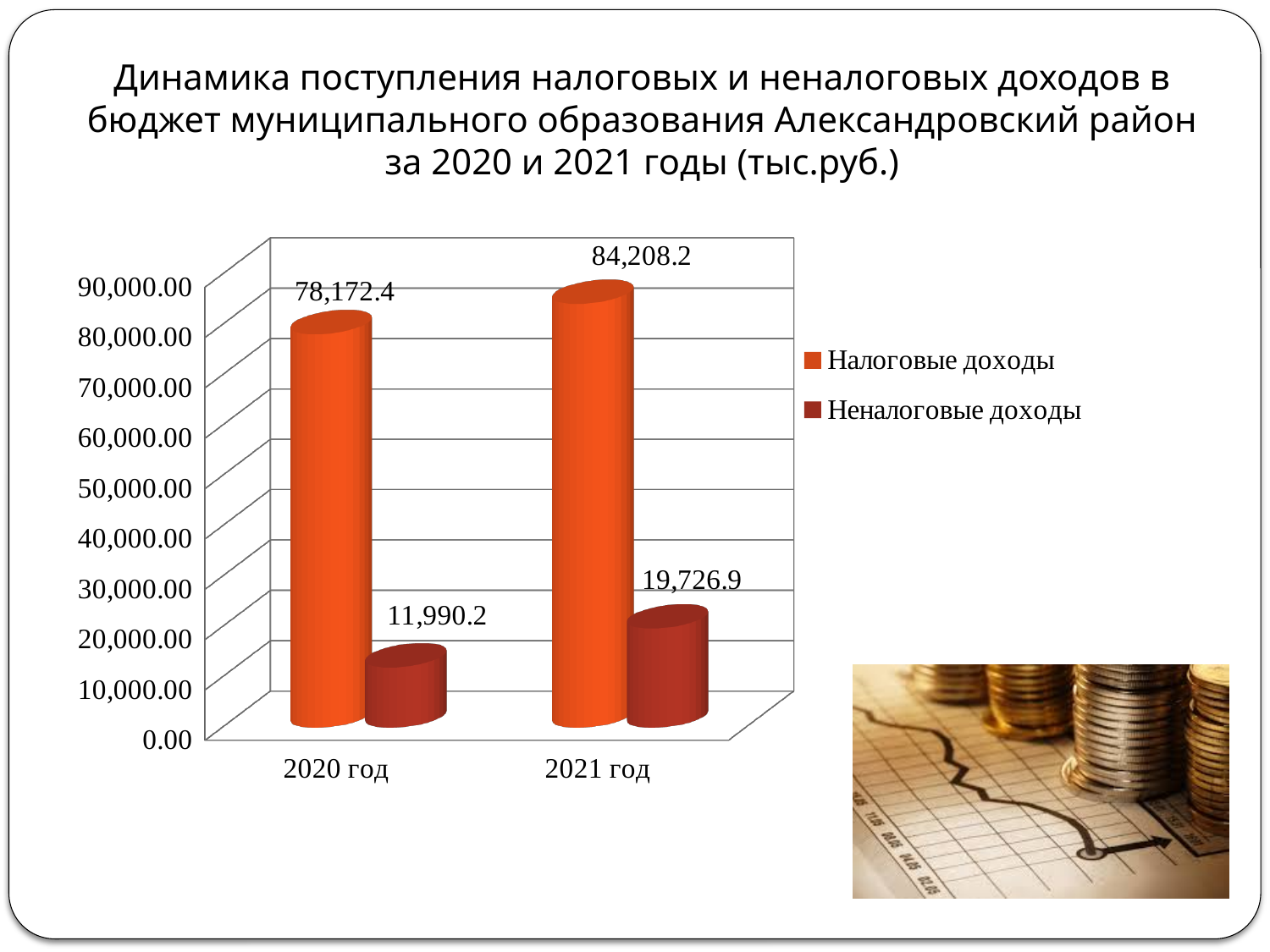
Do the values of Неналоговые доходы rise or fall from 2020 год to 2021 год? rise What is the difference between Неналоговые доходы in 2021 год and 2020 год? 7,736.7 What is the value of Налоговые доходы for 2021 год? 84,208.2 What is the value of Налоговые доходы for 2020 год? 78,172.4 In which year is Налоговые доходы highest? 2021 год What kind of chart is shown on the slide? bar chart Which is larger in 2021 год: Налоговые доходы or Неналоговые доходы? Налоговые доходы How many series does the legend list? 2 What is the value of Неналоговые доходы for 2020 год? 11,990.2 In which year is Неналоговые доходы lowest? 2020 год What is the value of Неналоговые доходы for 2021 год? 19,726.9 By how much did Налоговые доходы increase from 2020 год to 2021 год? 6,035.8